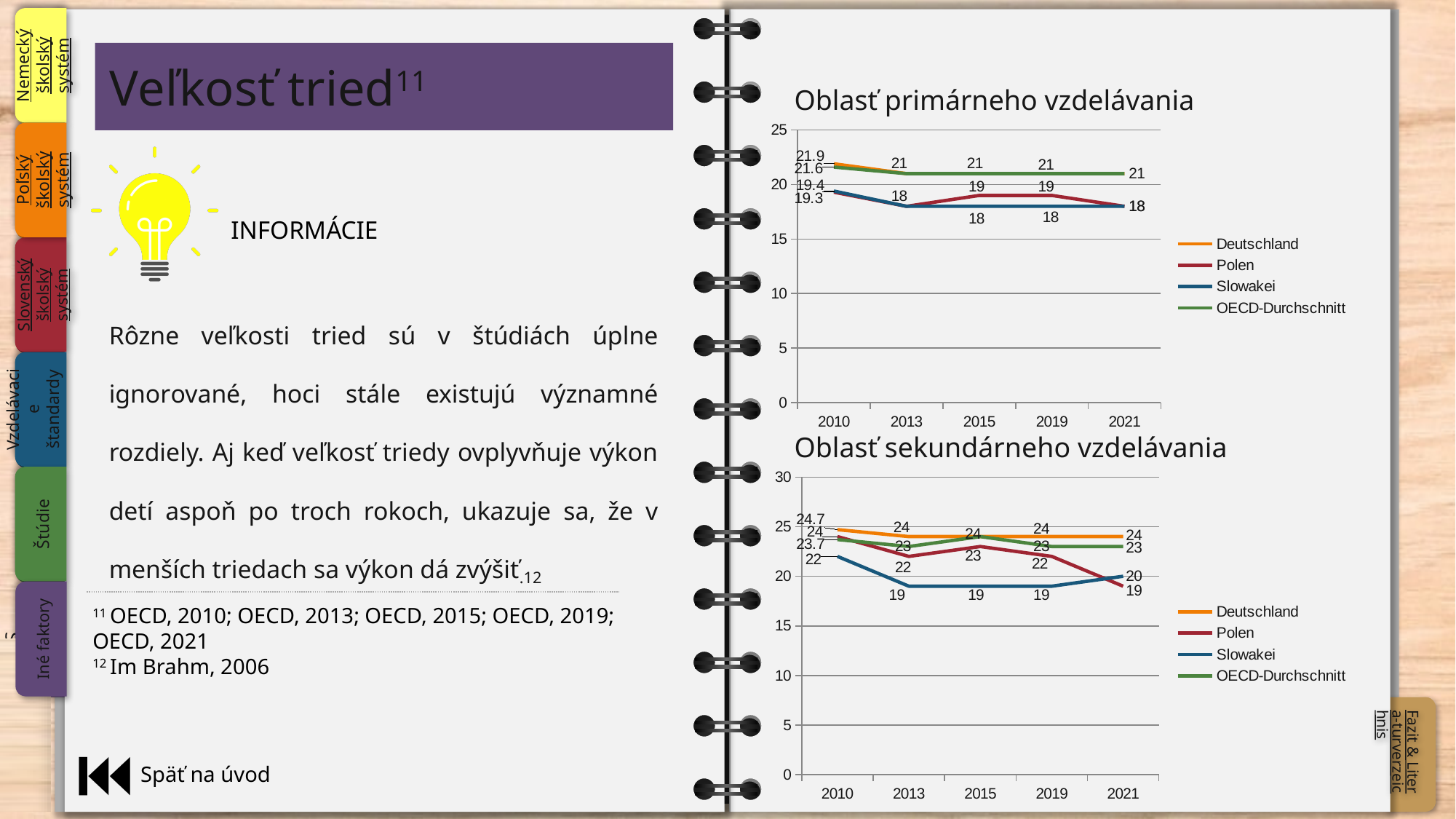
In 'Oblasť sekundárneho vzdelávania', what is the difference between Deutschland and Slowakei in 2013? 5 In 'Oblasť primárneho vzdelávania', what is the value for Polen in 2015? 19 In 'Oblasť primárneho vzdelávania', what is the value for Deutschland in 2010? 21.9 In 'Oblasť primárneho vzdelávania', is the value for Slowakei in 2021 greater or less than 20? less How many series does the legend of 'Oblasť sekundárneho vzdelávania' list? 4 What kind of chart is 'Oblasť primárneho vzdelávania'? line chart In 'Oblasť sekundárneho vzdelávania', what is the value for Deutschland in 2010? 24.7 How many years are shown on the x axis of 'Oblasť primárneho vzdelávania'? 5 In 'Oblasť sekundárneho vzdelávania', which series has the lowest value in 2019? Slowakei In 'Oblasť sekundárneho vzdelávania', which is larger in 2013: Deutschland or Slowakei? Deutschland In 'Oblasť sekundárneho vzdelávania', what is the value for Slowakei in 2021? 20 In 'Oblasť sekundárneho vzdelávania', what is the value for Slowakei in 2013? 19